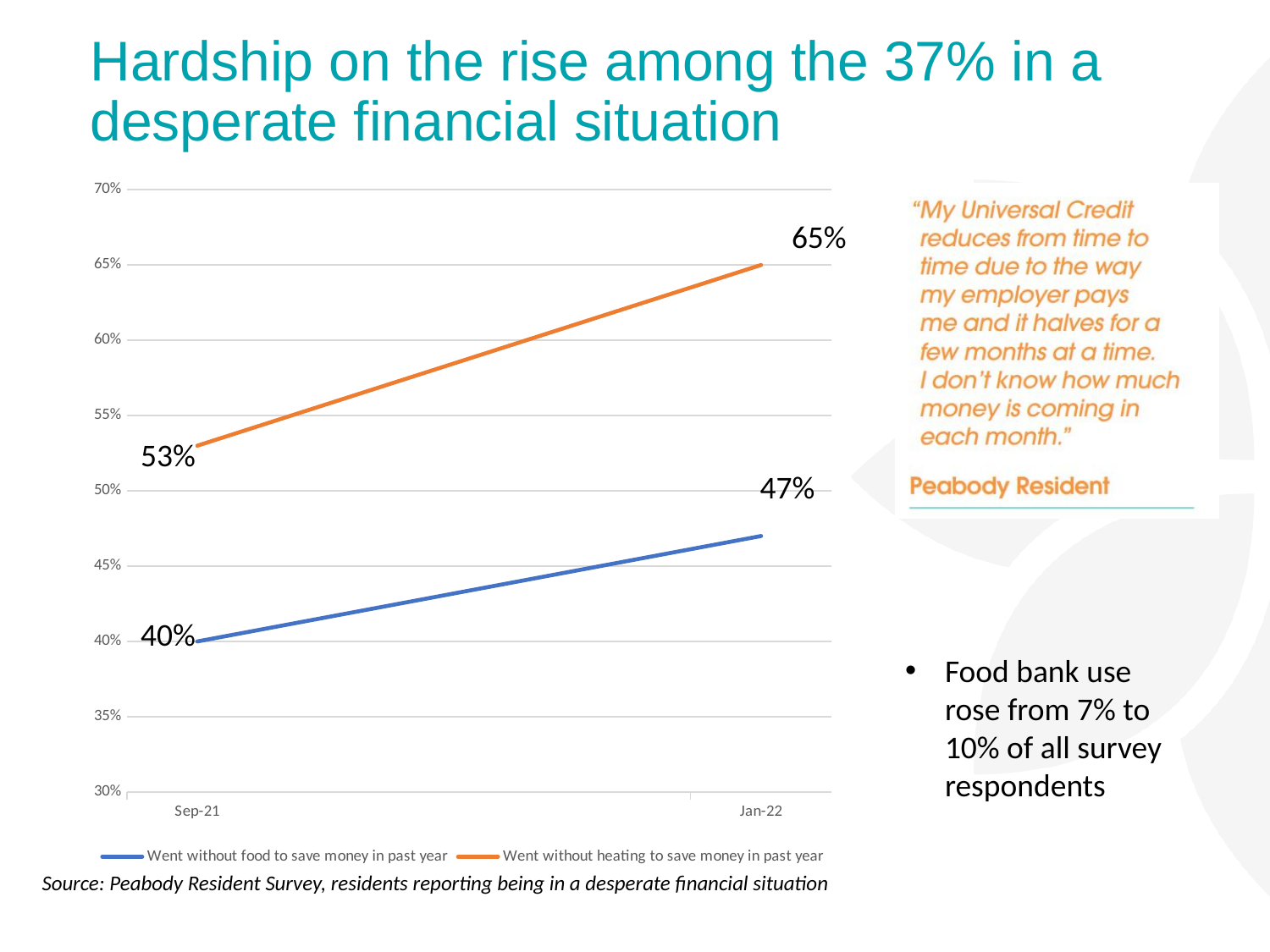
Which series has the higher value in Jan-22? Went without heating to save money in past year By how many percentage points did 'Went without food to save money in past year' change from Sep-21 to Jan-22? 7 percentage points What is the value for 'Went without food to save money in past year' in Jan-22? 47% What kind of chart is shown on the slide? line chart What is the value for 'Went without food to save money in past year' in Sep-21? 40% How many time points are plotted on the x axis? 2 How many series does the legend list? 2 Does the 'Went without food to save money in past year' series rise or fall from Sep-21 to Jan-22? rise What is the value for 'Went without heating to save money in past year' in Jan-22? 65% Which colour is used for the 'Went without heating to save money in past year' line? orange By how many percentage points did 'Went without heating to save money in past year' change from Sep-21 to Jan-22? 12 percentage points What is the value for 'Went without heating to save money in past year' in Sep-21? 53%